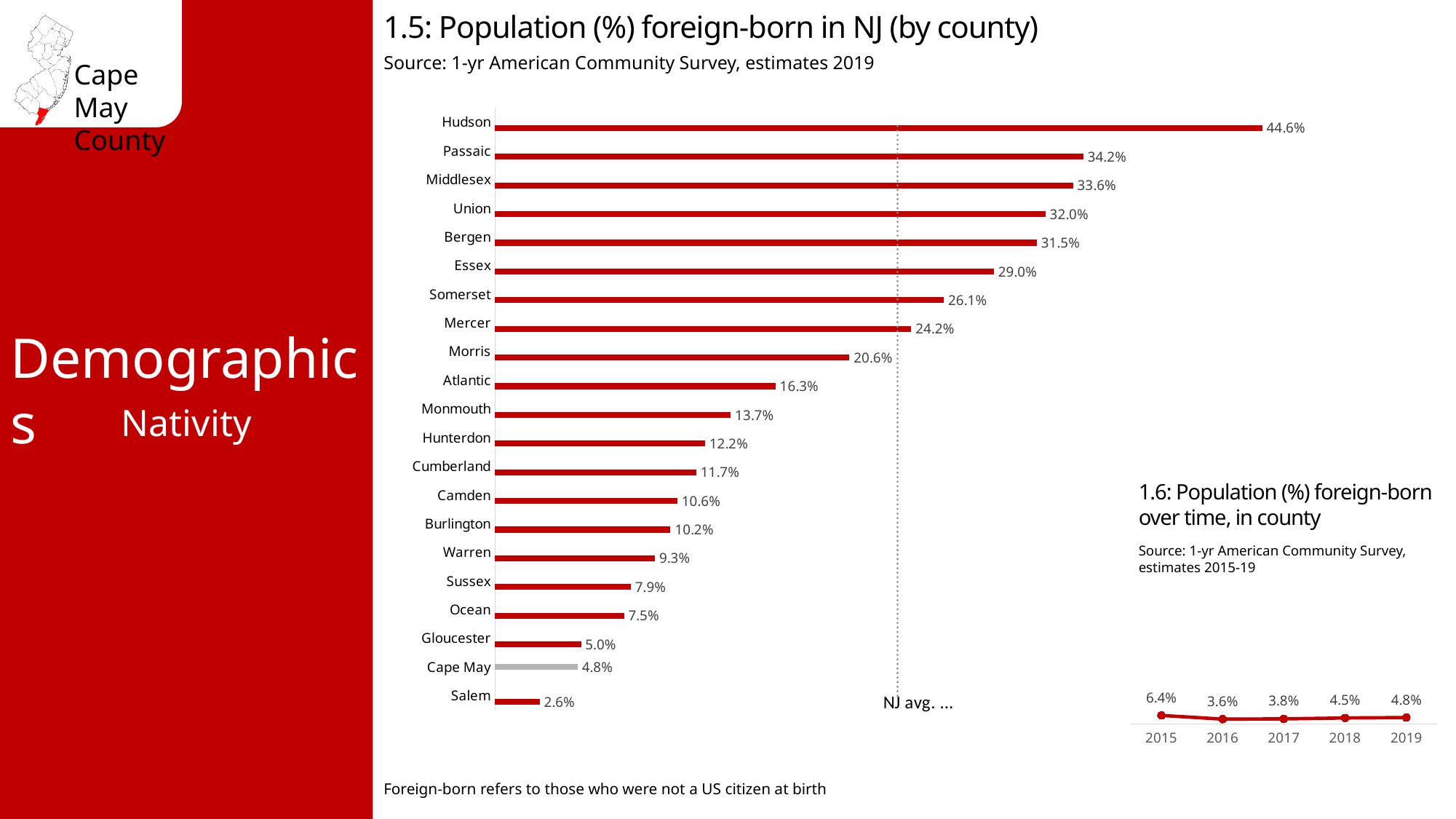
In chart 1.5, which county's bar is coloured grey instead of red? Cape May In chart 1.5, which county has a higher foreign-born percentage, Camden or Burlington? Camden In chart 1.5, how many counties are shown? 21 In chart 1.5, which county has the highest foreign-born percentage? Hudson In chart 1.5, which county has the lowest foreign-born percentage? Salem In chart 1.6, which year has the lowest foreign-born percentage? 2016 In chart 1.5, what is the foreign-born percentage for Hudson? 44.6% In chart 1.6, what is the foreign-born percentage in 2015? 6.4% In chart 1.6, do the values rise or fall from 2016 to 2019? Rise What kind of chart is chart 1.5? Bar chart In chart 1.5, what is the difference between the foreign-born percentages of Passaic and Middlesex? 0.6% In chart 1.5, what is the foreign-born percentage for Cape May? 4.8%